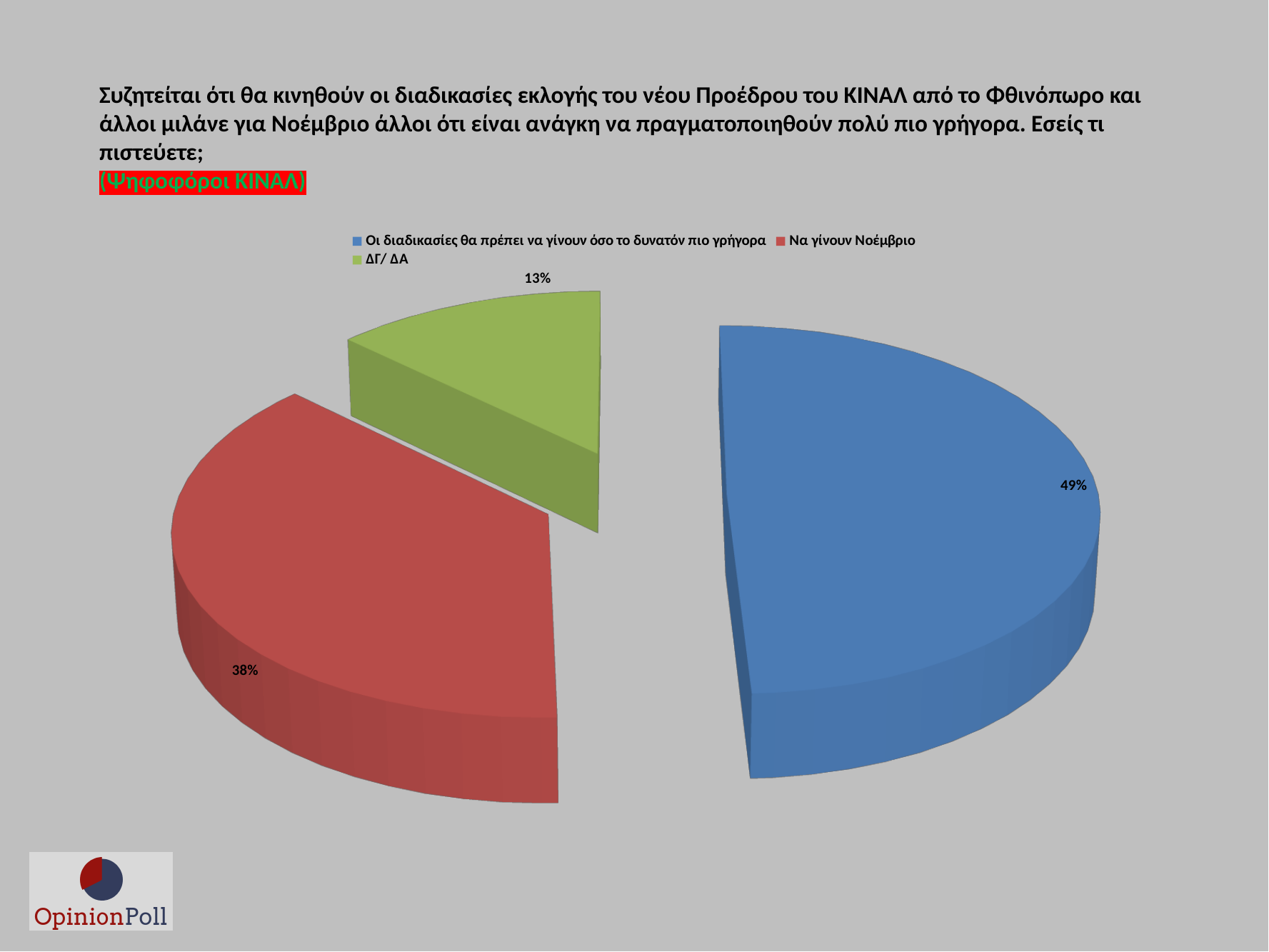
Which is larger: the share for "Να γίνουν Νοέμβριο" or the share for "ΔΓ/ ΔΑ"? Να γίνουν Νοέμβριο What percentage of respondents answered "ΔΓ/ ΔΑ"? 13% What percentage of respondents chose "Οι διαδικασίες θα πρέπει να γίνουν όσο το δυνατόν πιο γρήγορα"? 49% What is the difference in percentage points between "Να γίνουν Νοέμβριο" and "ΔΓ/ ΔΑ"? 25 percentage points What colour is the slice for "Να γίνουν Νοέμβριο"? red Which response has the largest share of the pie? Οι διαδικασίες θα πρέπει να γίνουν όσο το δυνατόν πιο γρήγορα What is the difference in percentage points between "Οι διαδικασίες θα πρέπει να γίνουν όσο το δυνατόν πιο γρήγορα" and "Να γίνουν Νοέμβριο"? 11 percentage points How many slices does the pie chart have? 3 What kind of chart is shown on the slide? pie chart What percentage of respondents chose "Να γίνουν Νοέμβριο"? 38% How many entries does the legend list? 3 Which response has the smallest share of the pie? ΔΓ/ ΔΑ